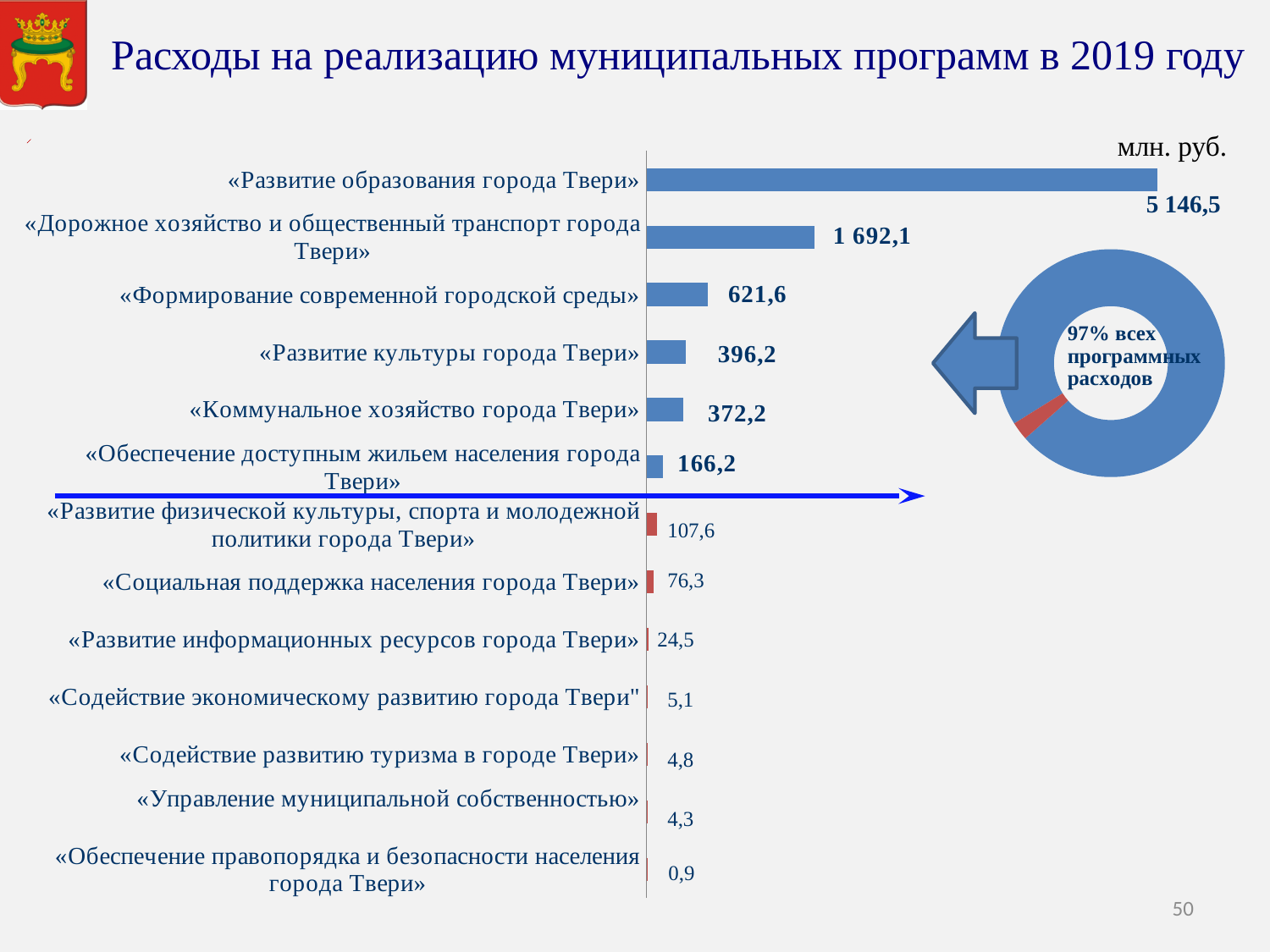
What share of all program expenditures does the donut chart highlight? 97% Which program has the lowest expenditure? «Обеспечение правопорядка и безопасности населения города Твери» What kind of chart is used to show the program expenditures? Bar chart What is the difference between the values for «Развитие образования города Твери» and «Дорожное хозяйство и общественный транспорт города Твери»? 3 454,4 What is the value for «Развитие образования города Твери»? 5 146,5 Which program has the highest expenditure? «Развитие образования города Твери» What is the difference between the values for «Формирование современной городской среды» and «Развитие культуры города Твери»? 225,4 How many programs (categories) are shown in the bar chart? 13 Which is larger: the value for «Социальная поддержка населения города Твери» or «Развитие информационных ресурсов города Твери»? «Социальная поддержка населения города Твери» What is the value for «Коммунальное хозяйство города Твери»? 372,2 What is the value for «Обеспечение правопорядка и безопасности населения города Твери»? 0,9 What is the value for «Дорожное хозяйство и общественный транспорт города Твери»? 1 692,1